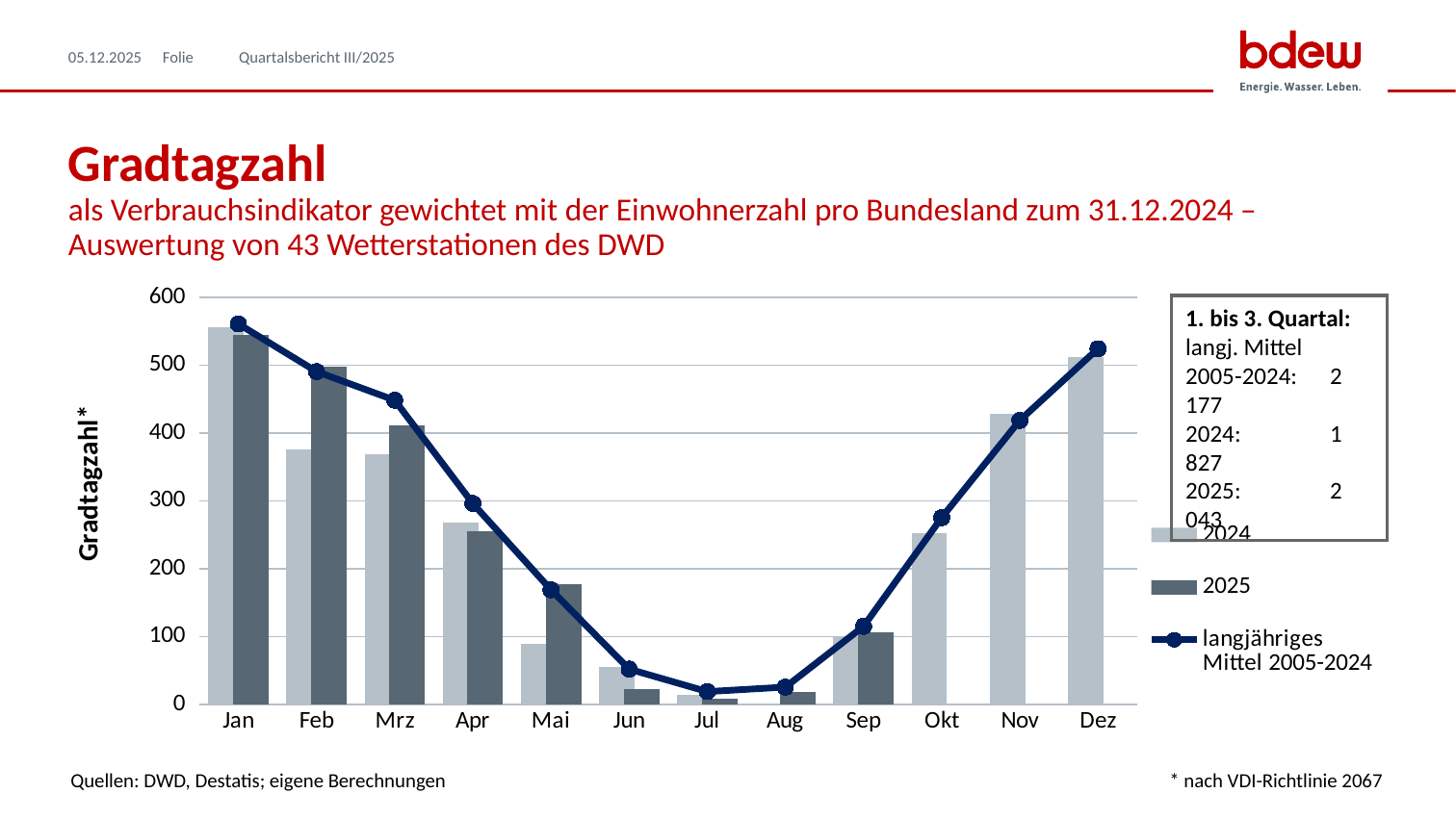
In which month does the line 'langjähriges Mittel 2005-2024' reach its lowest point? Jul What kind of chart is shown on the slide? A combined bar and line chart Does the line 'langjähriges Mittel 2005-2024' rise or fall from Jan to Jul? It falls Is the 2024 bar for Nov greater or less than 400? greater How many months are shown on the x axis of the chart? 12 What is the label of the y axis of the chart? Gradtagzahl* How many series does the chart legend list? 3 In Feb, which bar is larger, 2024 or 2025? 2025 Is the 2024 bar for Jan greater or less than 500? greater Is the 2024 bar for Jun greater or less than 100? less Which month has the highest value for the 2024 bars? Jan